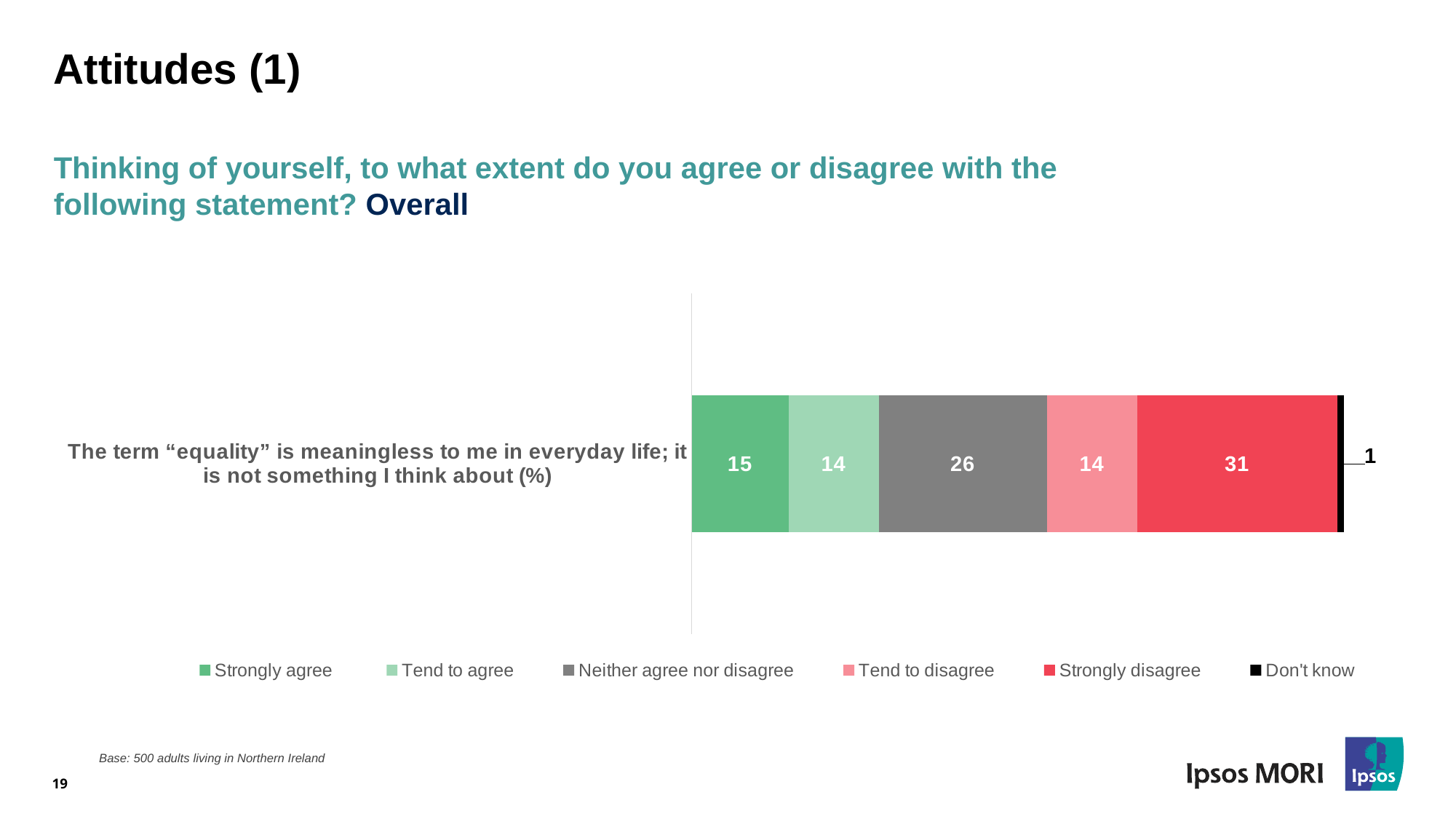
What is the difference between the "Strongly disagree" and "Strongly agree" values? 16 What is the total of the "Strongly agree" and "Tend to agree" segments? 29 Which is larger, the value for "Neither agree nor disagree" or the value for "Tend to disagree"? Neither agree nor disagree What colour is the "Strongly disagree" segment in the chart? Red What percentage of respondents strongly agree that the term "equality" is meaningless to them in everyday life? 15 What is the value for "Don't know" in the chart? 1 What is the value for "Neither agree nor disagree" in the chart? 26 Which response category has the highest value in the chart? Strongly disagree How many series does the legend list? 6 What is the value for "Strongly disagree" in the chart? 31 Which response category has the lowest value in the chart? Don't know What kind of chart is shown on the slide? Stacked bar chart